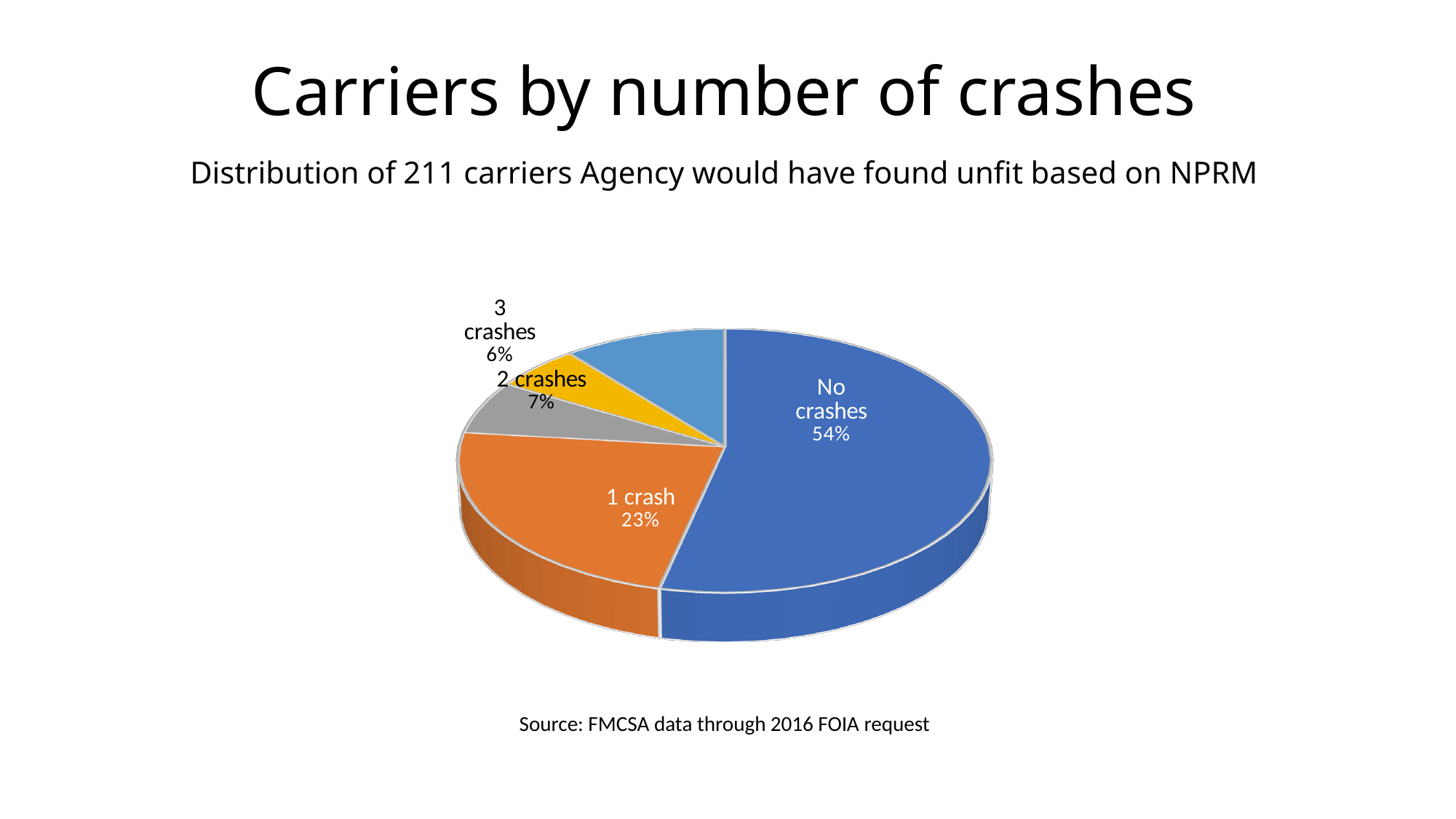
What colour is the 'No crashes' slice? Blue What share of carriers had 1 crash? 23% How many slices does the pie chart have? 5 Which labelled category has the largest share of the pie? No crashes Which labelled category has the smallest share of the pie? 3 crashes What kind of chart is shown on the slide? Pie chart What is the title of the slide? Carriers by number of crashes What share of carriers had 3 crashes? 6% What share of carriers had 2 crashes? 7% Which is larger, the share for 2 crashes or the share for 3 crashes? 2 crashes What is the difference in percentage points between the 'No crashes' and '1 crash' shares? 31